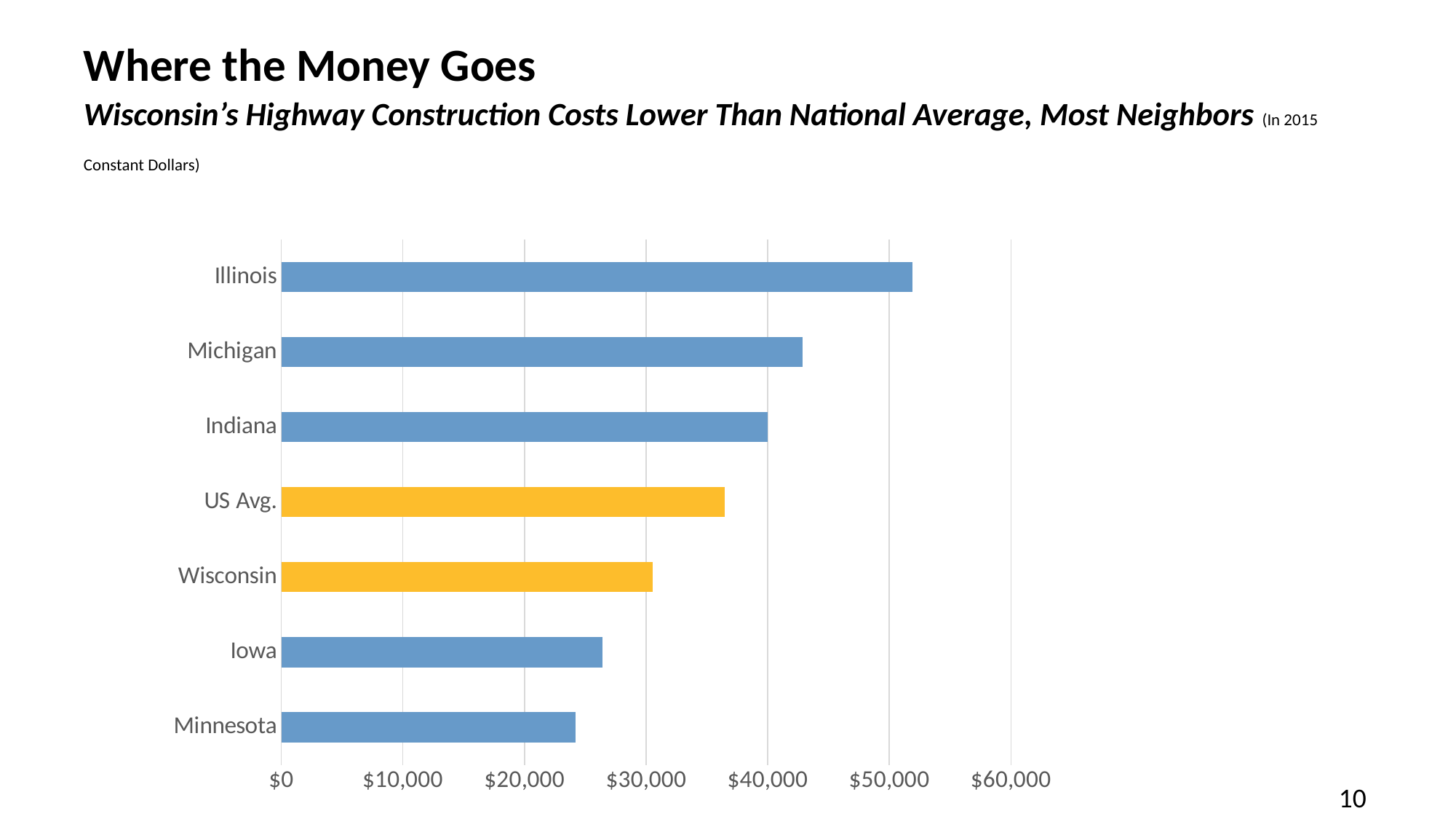
Is the value for Illinois greater or less than $50,000? greater Which two bars are coloured yellow rather than blue? US Avg. and Wisconsin Is the value for Minnesota greater or less than $20,000? greater What kind of chart is shown on the slide? bar chart Is the value for Michigan greater or less than $40,000? greater Which is larger, the value for Iowa or the value for Minnesota? Iowa Which is larger, the value for Wisconsin or the value for US Avg.? US Avg. Which category has the highest value? Illinois Which category has the lowest value? Minnesota How many categories are plotted in the chart? 7